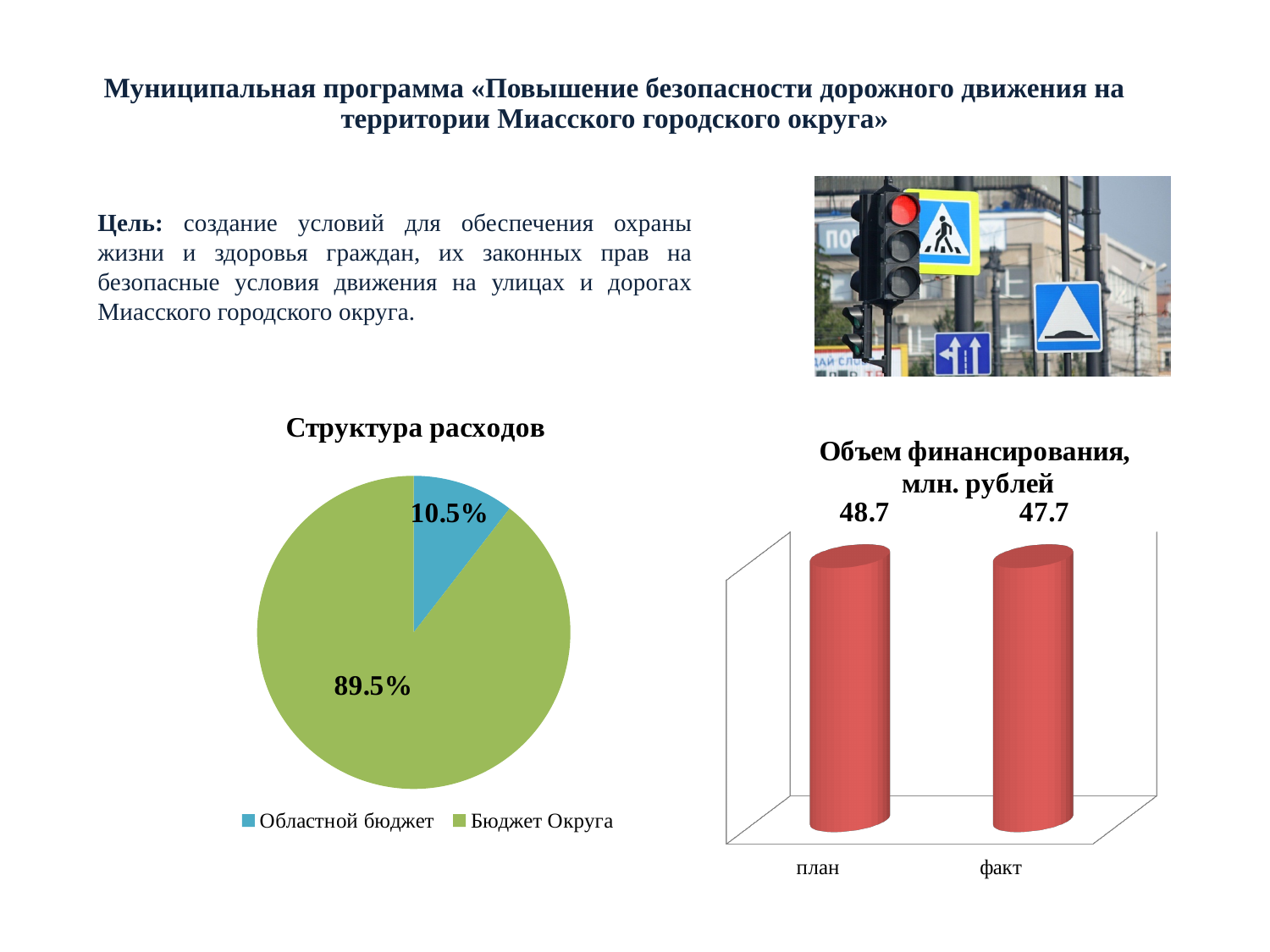
In the "Структура расходов" chart, what share does "Бюджет Округа" have? 89.5% In the "Структура расходов" chart, which slice is the largest? Бюджет Округа In the "Объем финансирования, млн. рублей" chart, how many bars are shown? 2 How many entries does the legend of the "Структура расходов" chart list? 2 In the "Структура расходов" chart, what share does "Областной бюджет" have? 10.5% In the "Объем финансирования, млн. рублей" chart, what is the value for "план"? 48.7 In the "Объем финансирования, млн. рублей" chart, what is the value for "факт"? 47.7 What kind of chart is "Структура расходов"? pie chart What kind of chart is "Объем финансирования, млн. рублей"? bar chart In the "Структура расходов" chart, what colour is the "Областной бюджет" slice? blue In the "Структура расходов" chart, which slice is the smallest? Областной бюджет In the "Объем финансирования, млн. рублей" chart, what is the difference between "план" and "факт"? 1.0